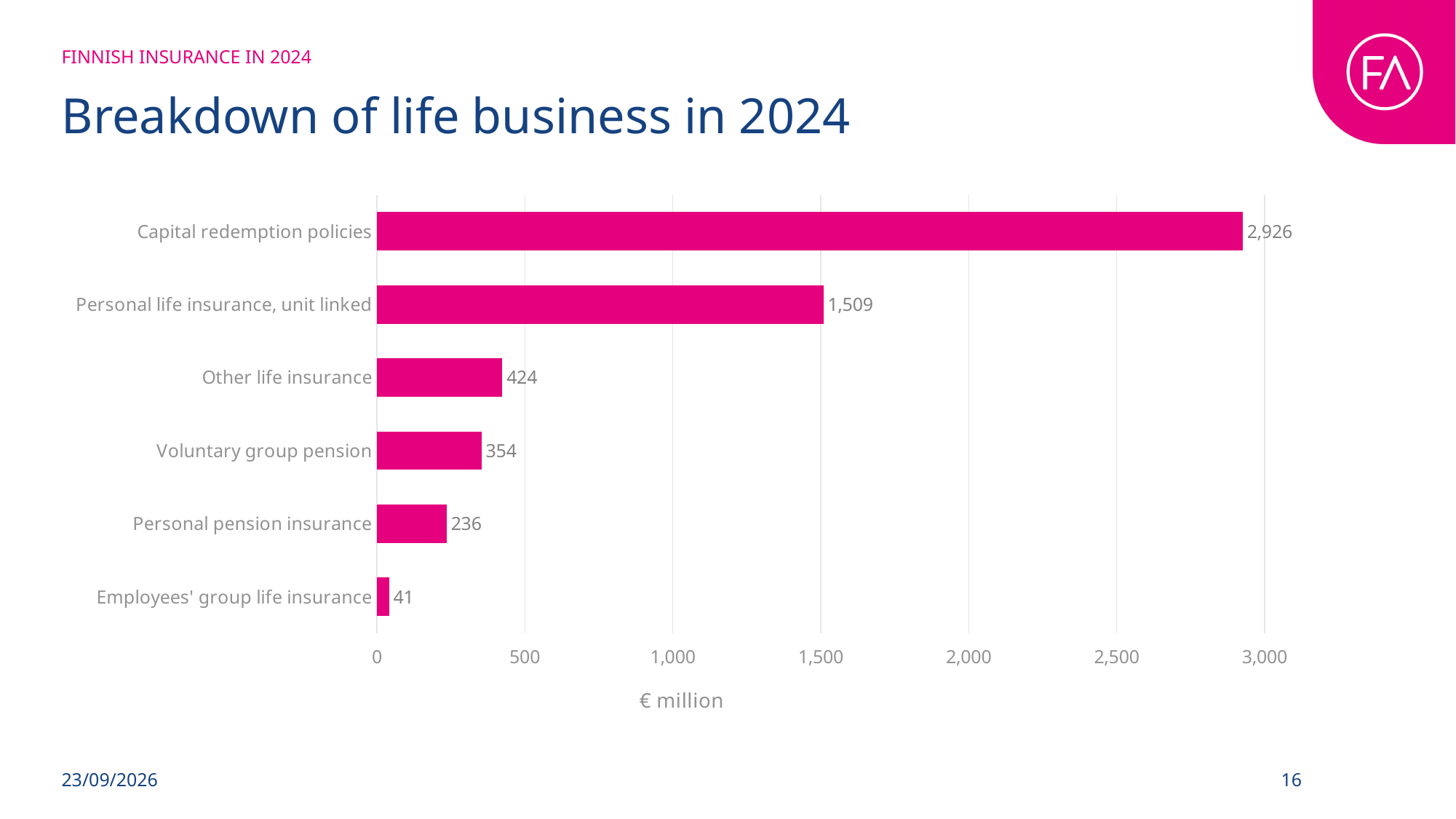
Which is larger, Personal pension insurance or Voluntary group pension? Voluntary group pension Which category has the highest value? Capital redemption policies What is the value for Personal life insurance, unit linked? 1,509 What is the value for Employees' group life insurance? 41 Which category has the lowest value? Employees' group life insurance What is the difference between Other life insurance and Voluntary group pension? 70 What unit is shown on the x axis of the chart? € million What kind of chart is shown on the slide? Bar chart What is the difference between Capital redemption policies and Personal life insurance, unit linked? 1,417 What is the value for Capital redemption policies? 2,926 What is the value for Voluntary group pension? 354 How many categories are shown in the chart? 6